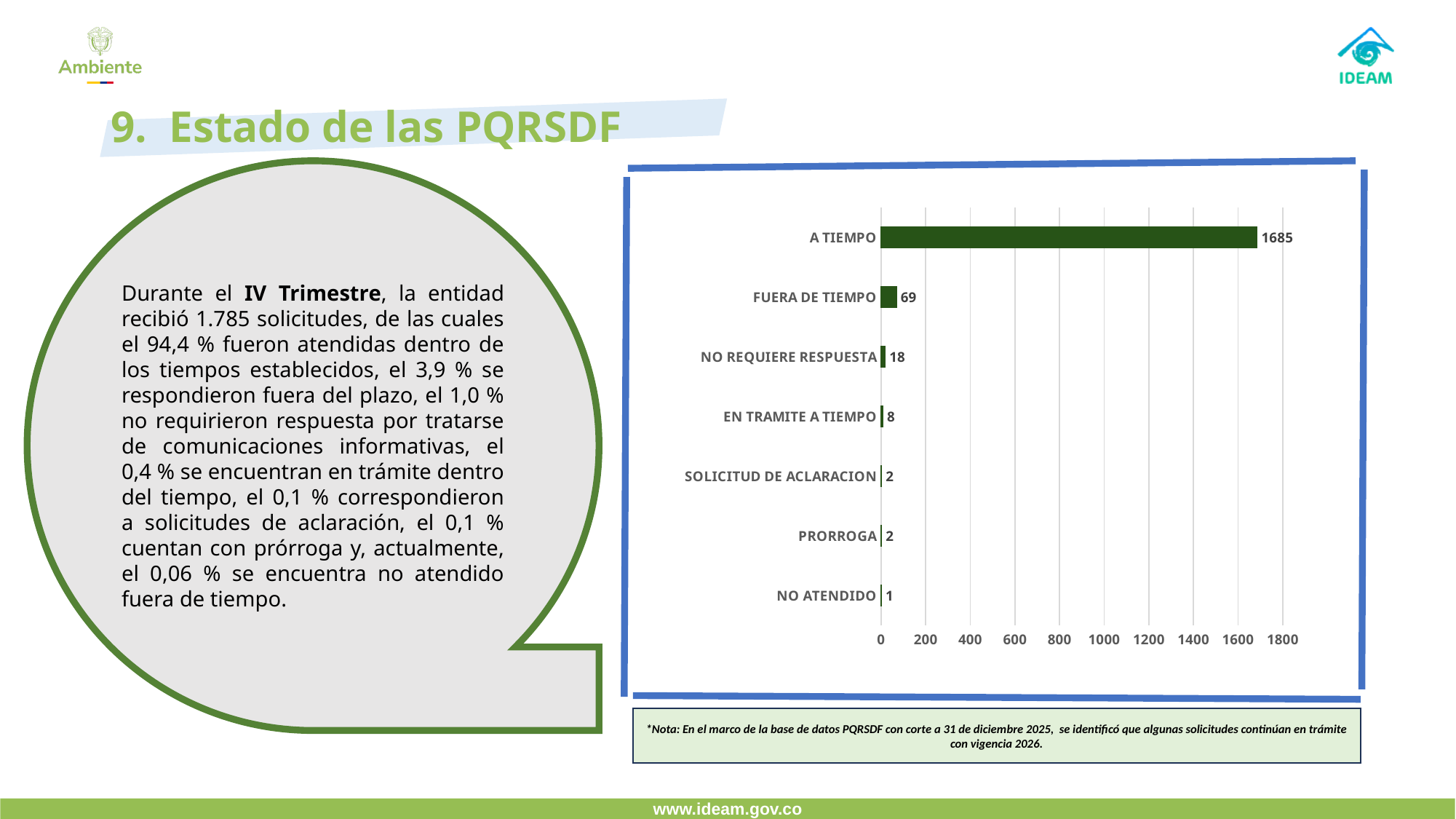
What is the value for A TIEMPO? 1685 Which category has the lowest value? NO ATENDIDO Which category has the highest value? A TIEMPO How many categories are shown in the chart? 7 What kind of chart is shown on the slide? bar chart What is the value for FUERA DE TIEMPO? 69 Is the value for A TIEMPO greater or less than 1600? greater What is the difference between the values for A TIEMPO and FUERA DE TIEMPO? 1616 What is the highest value shown on the horizontal axis of the chart? 1800 What is the value for NO REQUIERE RESPUESTA? 18 Which is larger, the value for FUERA DE TIEMPO or the value for NO REQUIERE RESPUESTA? FUERA DE TIEMPO What is the value for EN TRAMITE A TIEMPO? 8